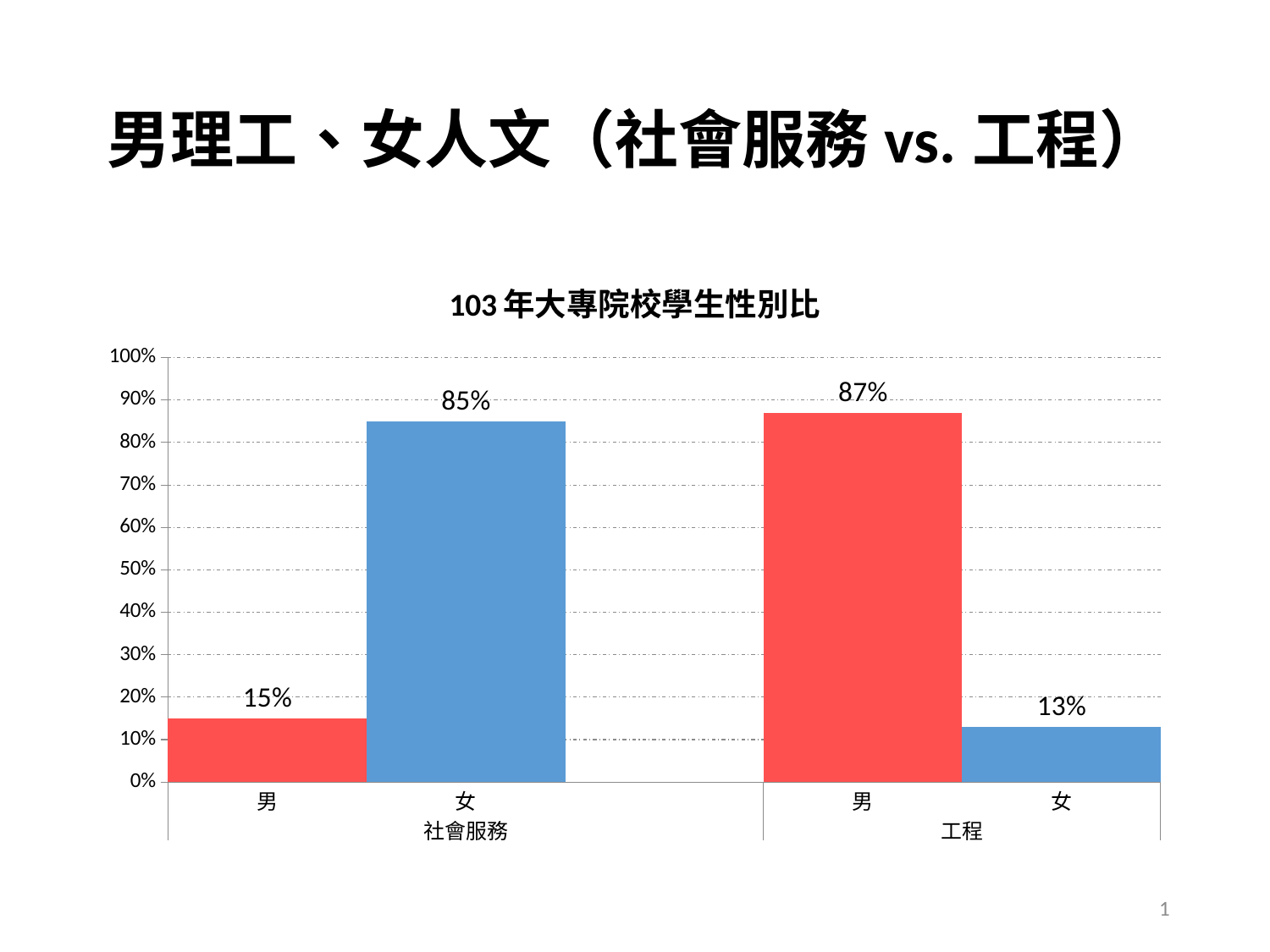
Which bar has the highest value on the chart? 男 in 工程 What is the title of the chart? 103 年大專院校學生性別比 What is the value for 男 in the 社會服務 group? 15% Is the value for 男 in 社會服務 greater or less than 20%? less What is the value for 男 in the 工程 group? 87% What is the value for 女 in the 工程 group? 13% What is the difference between the 女 and 男 values in the 社會服務 group? 70% Which bar has the lowest value on the chart? 女 in 工程 How many bars are plotted on the chart? 4 What kind of chart is shown on the slide? bar chart Which is larger: 男 in 工程 or 女 in 社會服務? 男 in 工程 What is the value for 女 in the 社會服務 group? 85%